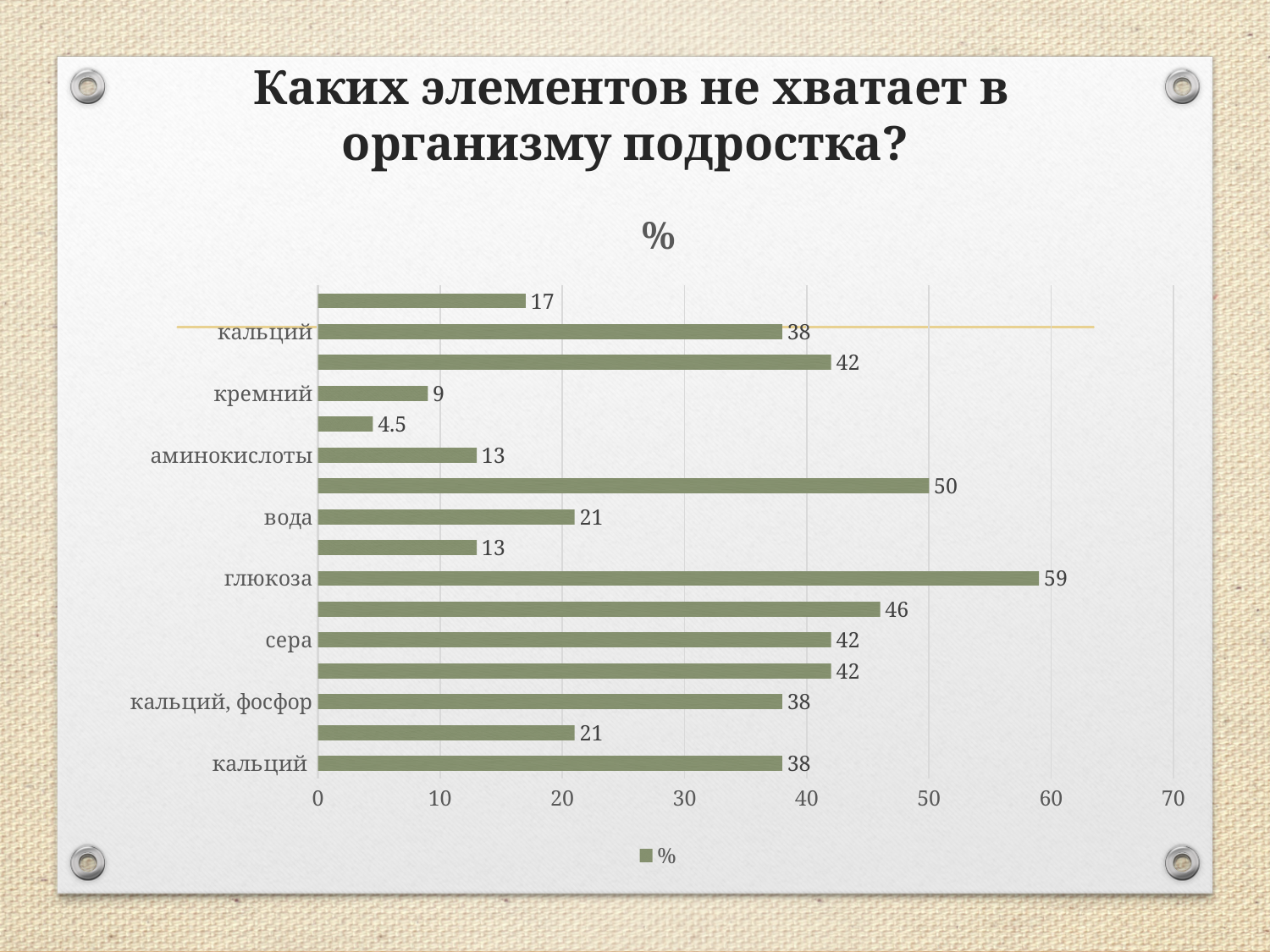
Which is larger, the value for сера or the value for вода? сера What is the value for сера? 42 What is the smallest value shown on the chart? 4.5 What is the value for кальций, фосфор? 38 What is the value for вода? 21 What is the value for аминокислоты? 13 How many series does the legend list? 1 What kind of chart is shown on the slide? bar chart What is the value for глюкоза? 59 What is the value for кремний? 9 Which labeled category has the highest value? глюкоза What is the difference between the values for глюкоза and сера? 17